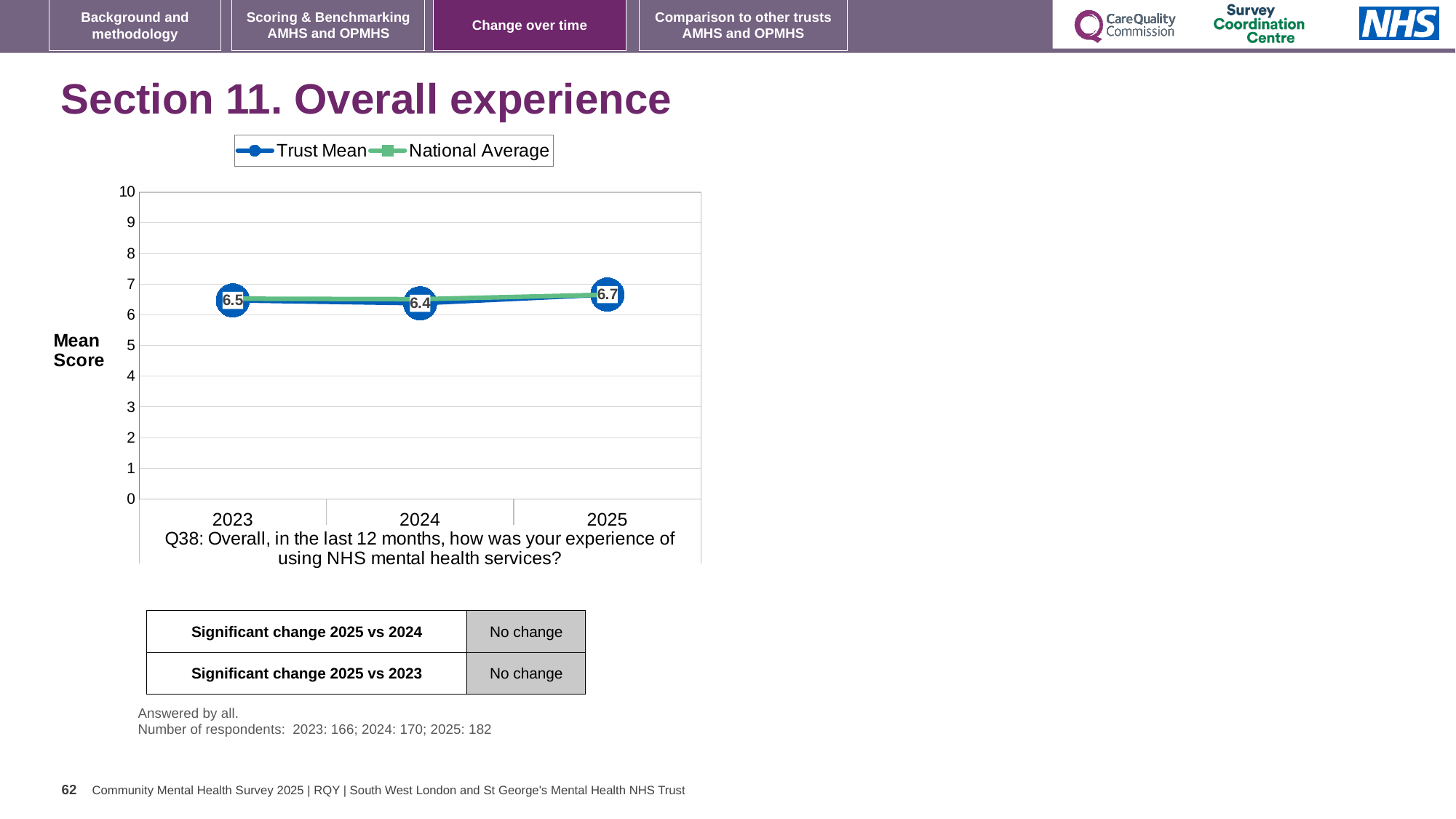
What is the Trust Mean value for 2024? 6.4 Is the National Average value for 2025 greater or less than 5? greater In which year is the Trust Mean lowest? 2024 How many years are shown on the x axis? 3 What is the difference between the Trust Mean in 2025 and in 2024? 0.3 How many series does the legend list? 2 Does the Trust Mean rise or fall from 2024 to 2025? Rise Which is larger, the Trust Mean for 2023 or for 2025? 2025 What kind of chart is shown on the slide? Line chart What is the Trust Mean value for 2023? 6.5 In which year is the Trust Mean highest? 2025 What is the Trust Mean value for 2025? 6.7